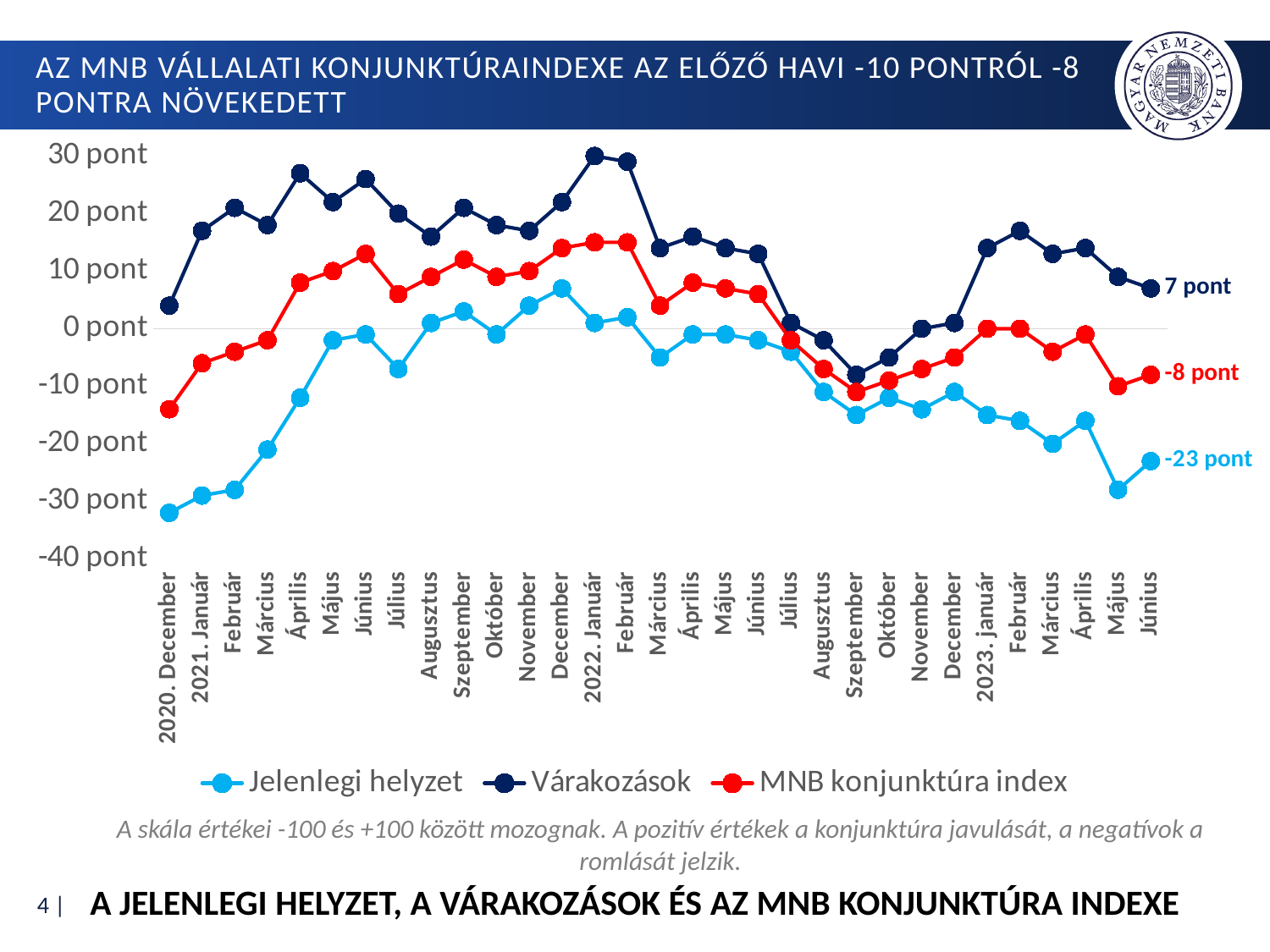
What is the value of Várakozások for 2023 Június? 7 pont What is the value of the MNB konjunktúra index for 2023 Június? -8 pont Is the value of Jelenlegi helyzet for 2020. December greater or less than -20 pont? less How many months are shown on the x axis? 31 Which series has the highest value in 2023 Június? Várakozások What is the value of Jelenlegi helyzet for 2023 Június? -23 pont What is the difference between Várakozások and the MNB konjunktúra index in 2023 Június? 15 pont What kind of chart is shown on the slide? line chart What is the difference between Várakozások and Jelenlegi helyzet in 2023 Június? 30 pont Is the value of Várakozások for 2022. Január greater or less than 20 pont? greater How many series does the legend list? 3 Does the Jelenlegi helyzet series rise or fall from 2020. December to 2021 Június? rise